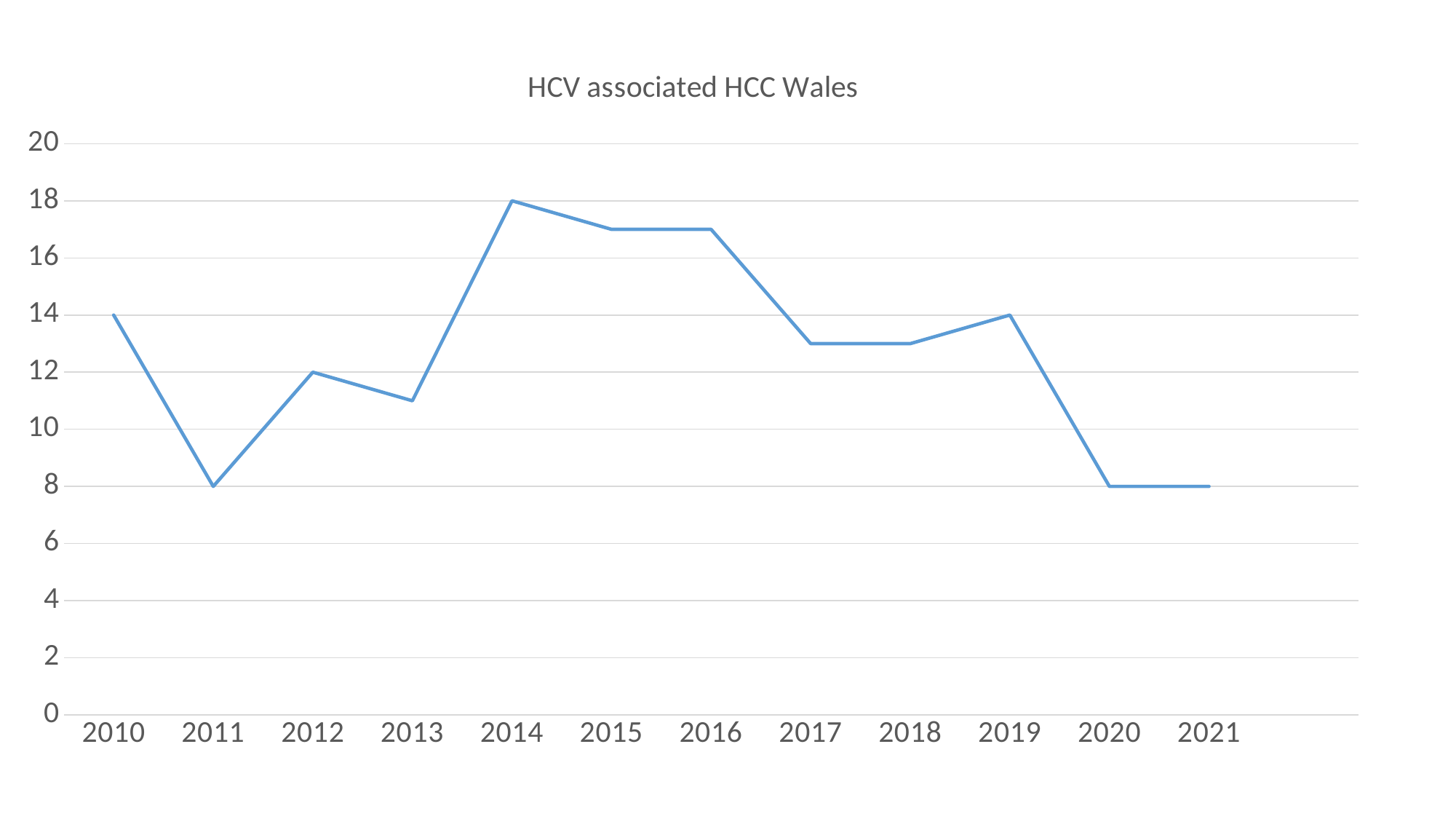
What is the difference between the values for 2014 and 2011? 10 Which is larger, the value for 2019 or the value for 2020? 2019 What is the value for 2012? 12 Which year has the highest value? 2014 What is the value for 2014? 18 How many years are plotted on the x axis? 12 What is the value for 2011? 8 Do the values rise or fall from 2019 to 2021? fall What kind of chart is this? line chart Is the value for 2015 greater or less than 16? greater What is the value for 2010? 14 Is the value for 2013 greater or less than 12? less